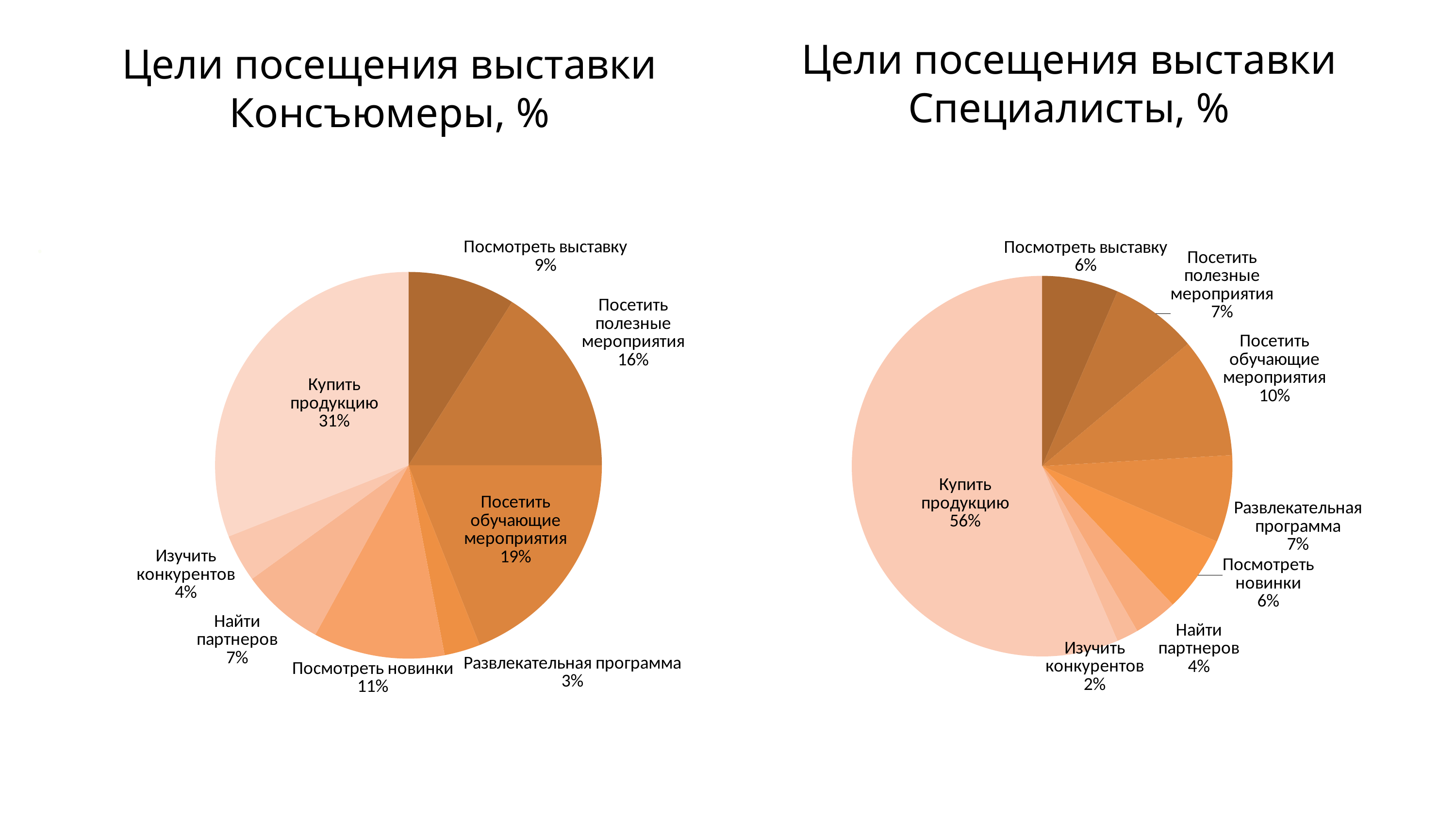
In the right chart (Специалисты, %), what is the value for Купить продукцию? 56% In the left chart (Консъюмеры, %), how many slices does the pie have? 8 In the left chart (Консъюмеры, %), what is the difference between Посетить полезные мероприятия and Посмотреть выставку? 7% What is the title of the chart on the right side of the slide? Цели посещения выставки Специалисты, % In the right chart (Специалисты, %), which category has the smallest share? Изучить конкурентов In the left chart (Консъюмеры, %), what is the value for Купить продукцию? 31% In the right chart (Специалисты, %), what is the value for Развлекательная программа? 7% In the left chart (Консъюмеры, %), which category has the smallest share? Развлекательная программа In the left chart (Консъюмеры, %), what is the value for Посетить обучающие мероприятия? 19% What kind of chart is shown on the left side of the slide (Консъюмеры)? Pie chart In the right chart (Специалисты, %), which category has the largest share? Купить продукцию In the right chart (Специалисты, %), which is larger: Посетить обучающие мероприятия or Найти партнеров? Посетить обучающие мероприятия